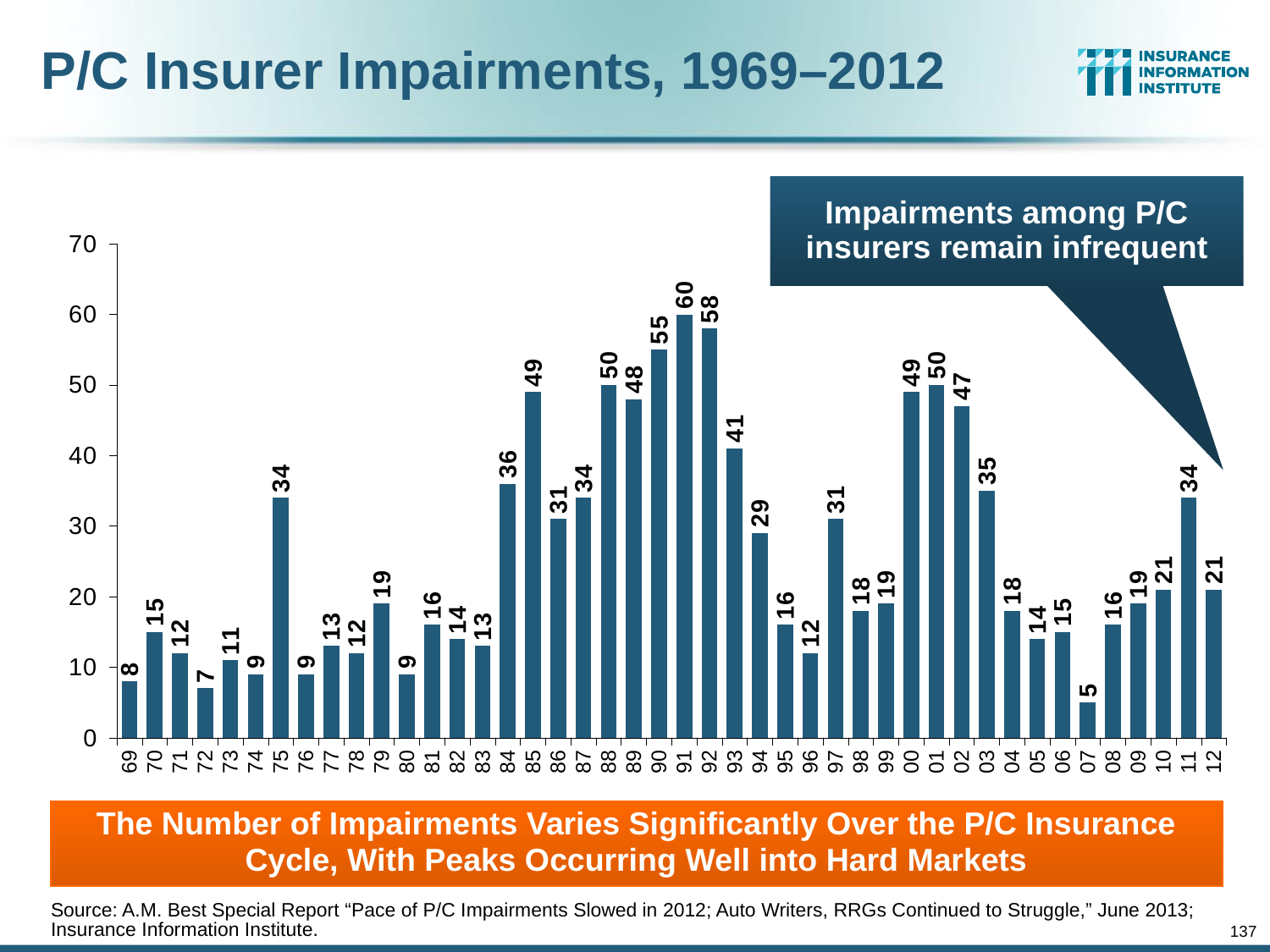
What is the number of impairments shown for 1985? 49 What is the difference between the impairments in 1991 and 1992? 2 Which year has the lowest number of impairments? 2007 What type of chart is shown on the slide? Bar chart What is the number of P/C insurer impairments shown for 1991? 60 What is the title of the chart on the slide? P/C Insurer Impairments, 1969–2012 What is the number of impairments shown for 2007? 5 What is the difference between the impairments in 2011 and 2012? 13 Which year had more impairments, 2001 or 2002? 2001 How many years are plotted on the chart? 44 What is the number of impairments shown for 2012? 21 Which year has the highest number of impairments? 1991